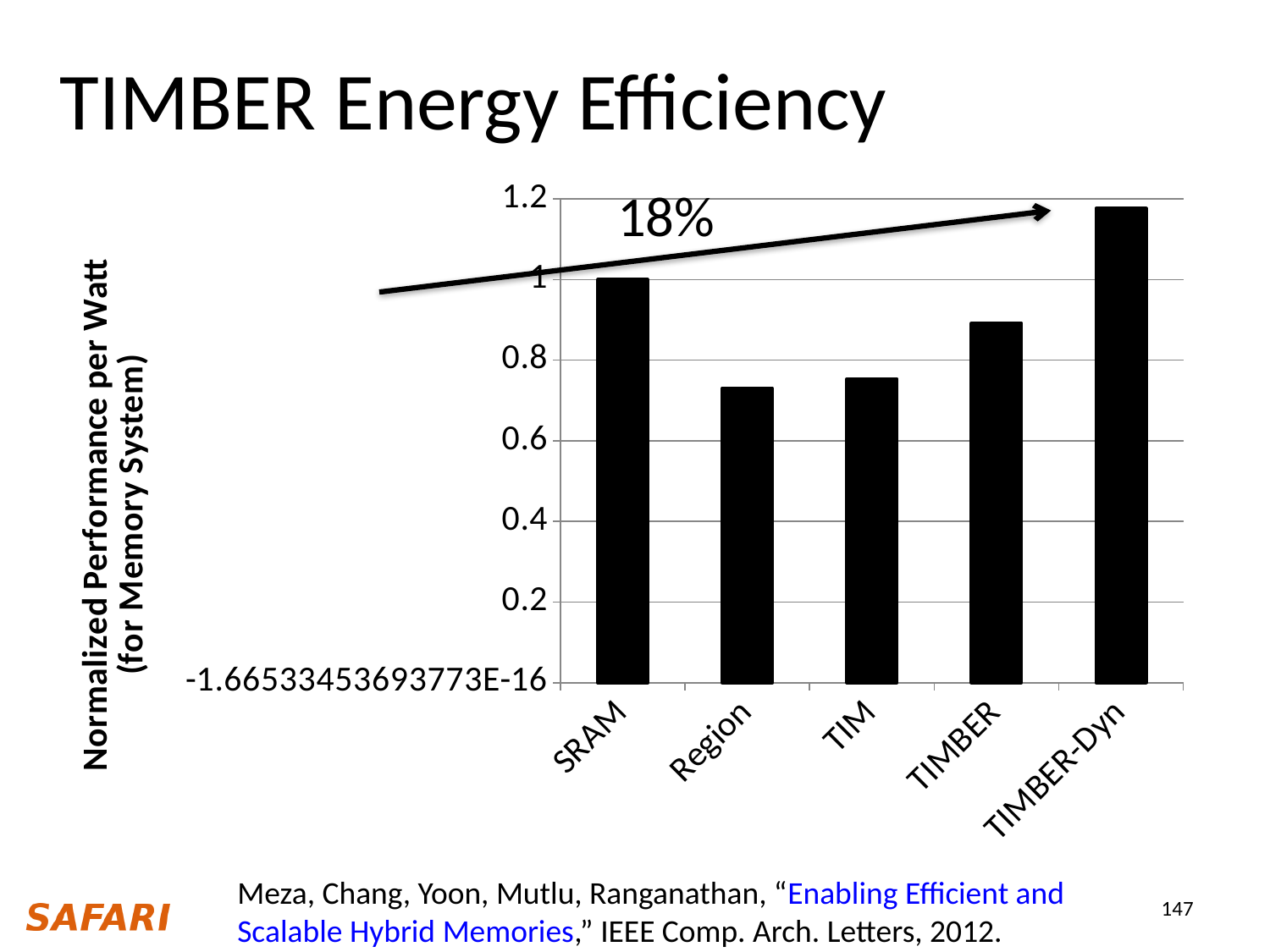
Is the value for Region greater or less than 0.8? less What percentage improvement is annotated with the arrow on the chart? 18% Which has a higher normalized performance per watt, SRAM or Region? SRAM Is the value for TIM greater or less than 0.8? less Which has a higher normalized performance per watt, TIMBER or TIM? TIMBER Is the value for TIMBER greater or less than 0.8? greater How many categories are shown on the x axis of the chart? 5 What is the normalized performance per watt for SRAM? 1 Which category has the highest normalized performance per watt? TIMBER-Dyn What kind of chart is shown on the slide? bar chart